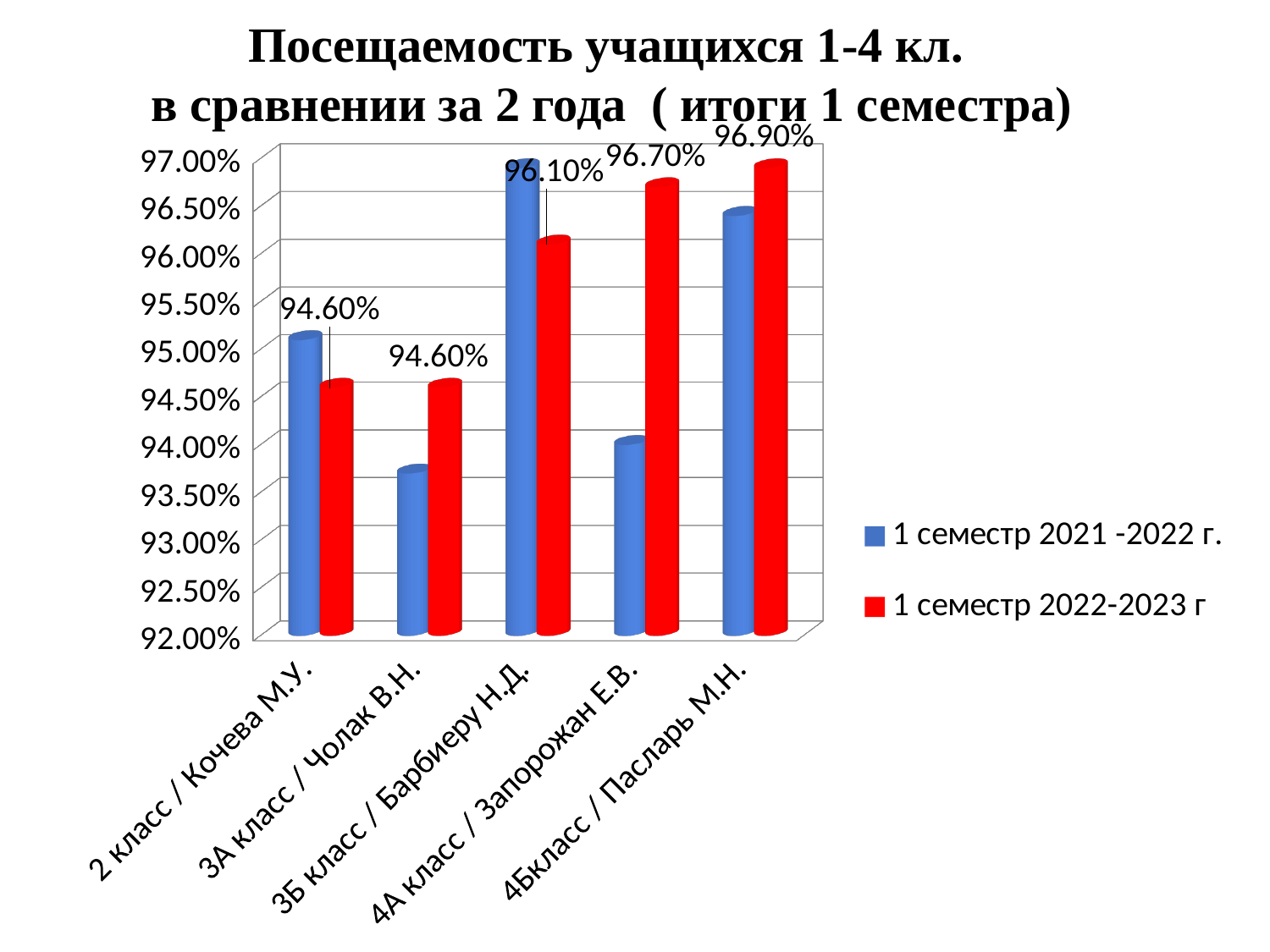
Which category has the highest value in the 1 семестр 2021 -2022 г. series? 3Б класс / Барбиеру Н.Д. How many series does the legend list? 2 How many classes are shown on the x axis? 5 What is the value for 4А класс / Запорожан Е.В. in the 1 семестр 2022-2023 г series? 96.70% What is the value for 2 класс / Кочева М.У. in the 1 семестр 2022-2023 г series? 94.60% What is the difference between the 1 семестр 2022-2023 г values for 4Бкласс / Пасларь М.Н. and 4А класс / Запорожан Е.В.? 0.20% What is the value for 3Б класс / Барбиеру Н.Д. in the 1 семестр 2022-2023 г series? 96.10% Which category has the highest value in the 1 семестр 2022-2023 г series? 4Бкласс / Пасларь М.Н. What kind of chart is shown on the slide? bar chart Is the 1 семестр 2021 -2022 г. value for 4Бкласс / Пасларь М.Н. greater or less than 96.00%? greater In the 1 семестр 2022-2023 г series, which is larger: 4А класс / Запорожан Е.В. or 3Б класс / Барбиеру Н.Д.? 4А класс / Запорожан Е.В. Is the 1 семестр 2021 -2022 г. value for 3А класс / Чолак В.Н. greater or less than 94.00%? less